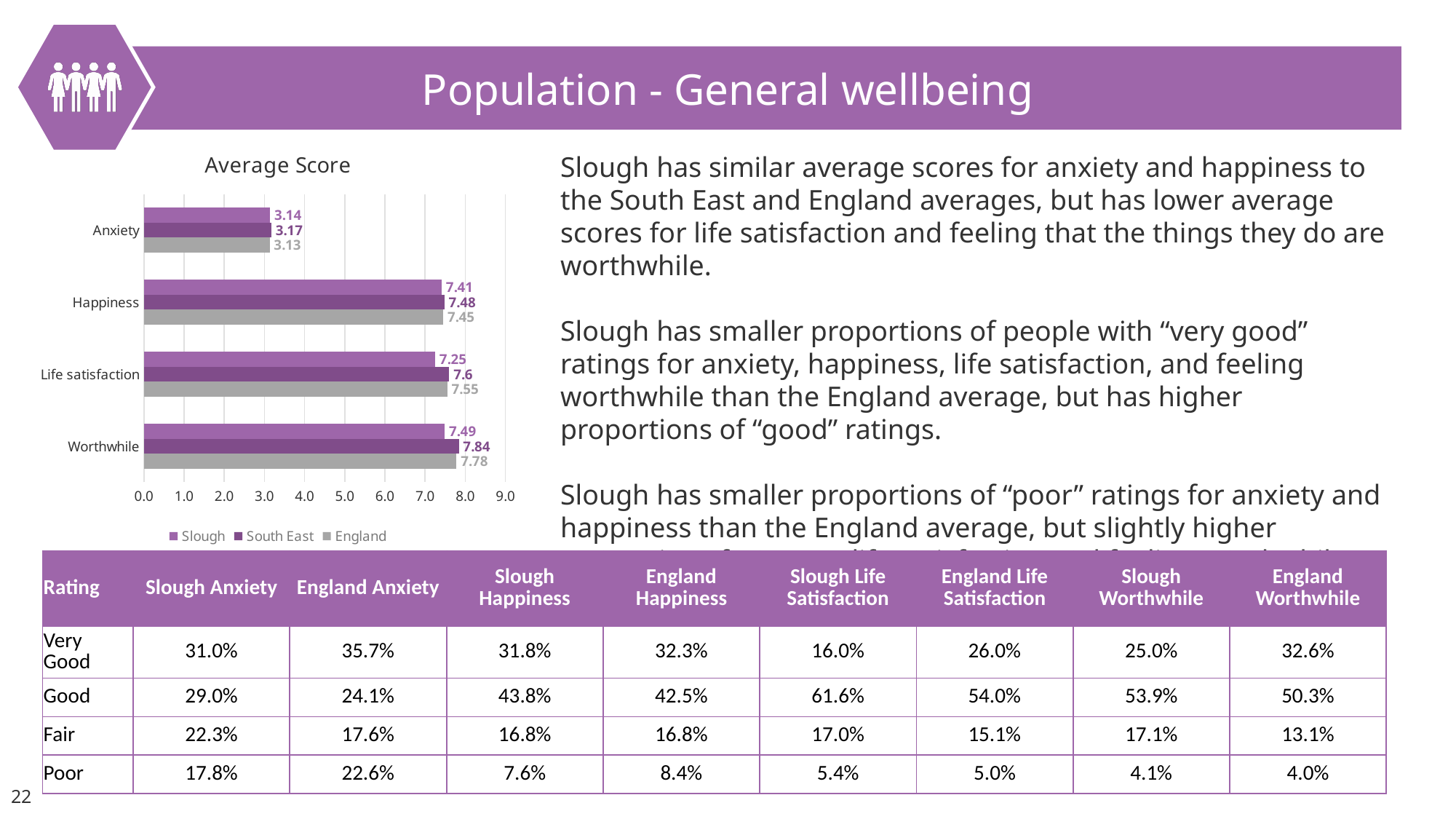
What is the England average score for Life satisfaction? 7.55 What kind of chart is the Average Score chart? Bar chart What is the difference between the England and Slough average scores for Life satisfaction? 0.3 What is the South East average score for Worthwhile? 7.84 How many categories are shown on the Average Score chart? 4 Which category has the lowest average score for Slough? Anxiety What is the title of the chart on the slide? Average Score What is the Slough average score for Anxiety? 3.14 What is the difference between the South East and Slough average scores for Worthwhile? 0.35 Which is larger for Happiness: the Slough score or the South East score? South East How many series does the legend of the Average Score chart list? 3 Which category has the highest average score for South East? Worthwhile